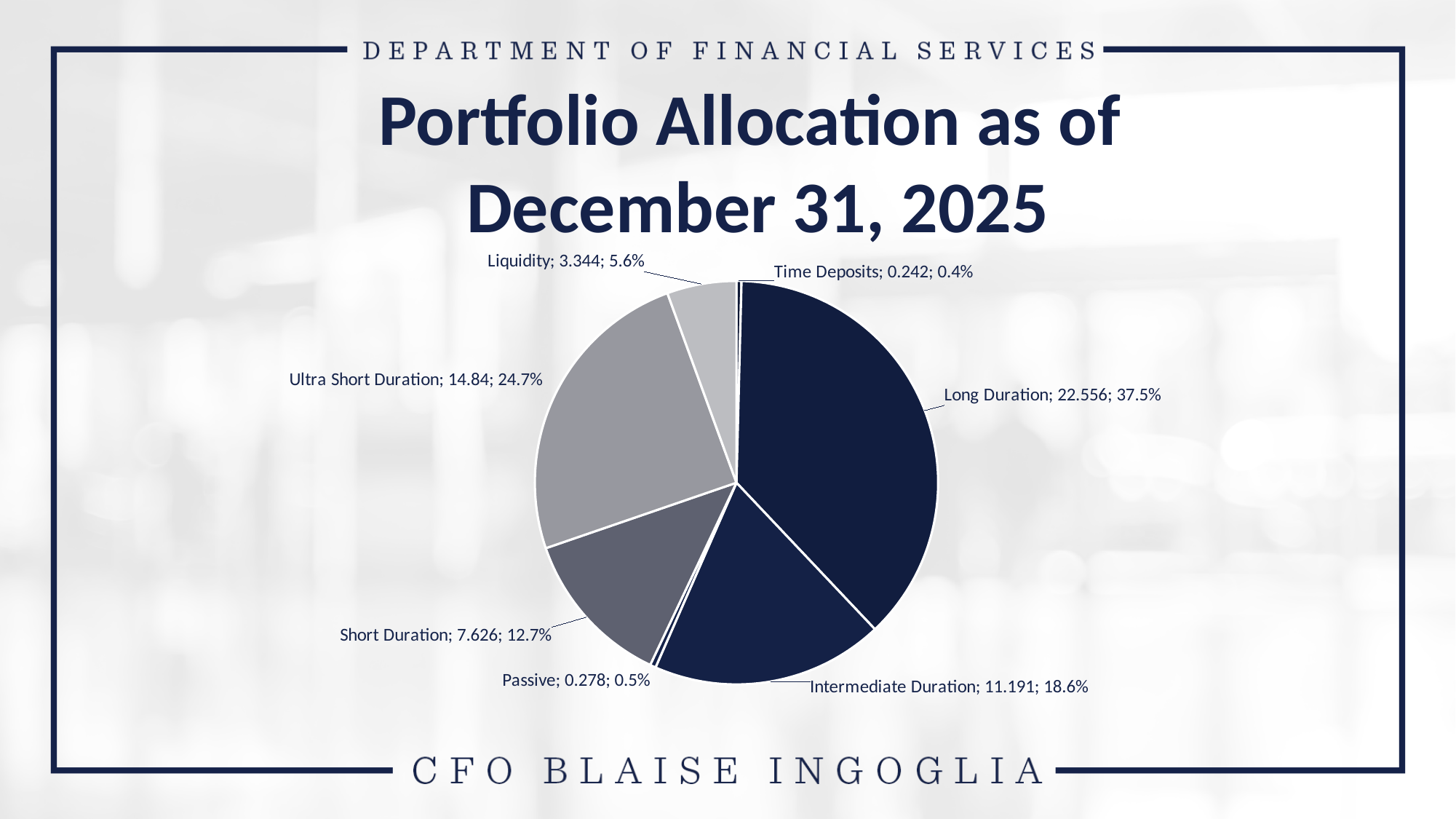
What percentage share does Ultra Short Duration have? 24.7% What is the title of the chart on the slide? Portfolio Allocation as of December 31, 2025 Which category has the smallest slice of the pie? Time Deposits What is the value shown for Intermediate Duration? 11.191 What percentage share does Passive have? 0.5% What percentage share does Liquidity have? 5.6% What kind of chart is shown on the slide? Pie chart Which category has the largest slice of the pie? Long Duration Which is larger, Short Duration or Intermediate Duration? Intermediate Duration What is the difference between the values for Long Duration and Ultra Short Duration? 7.716 What is the value shown for Long Duration? 22.556 How many categories are shown in the pie chart? 7